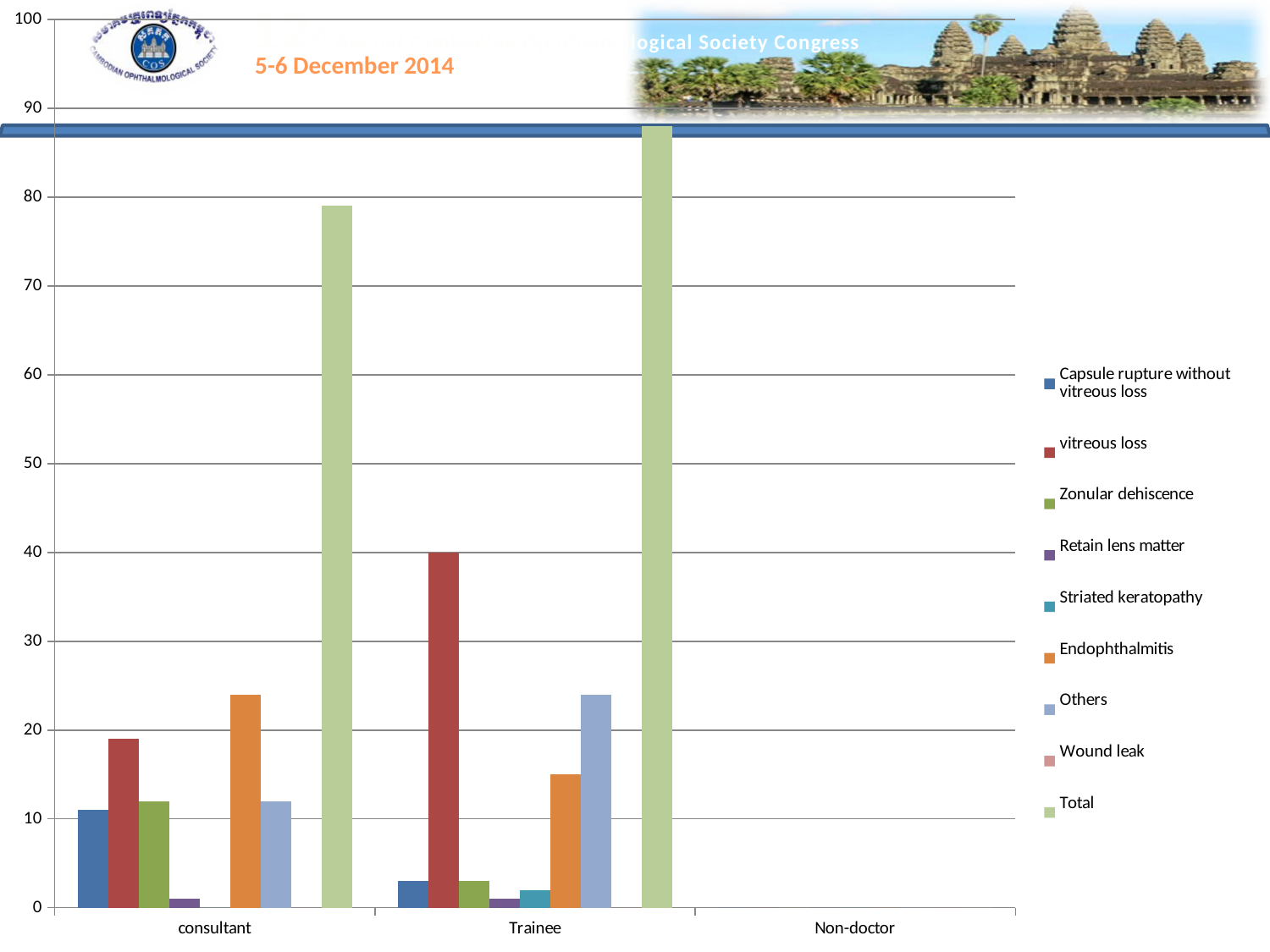
Which is larger: Others for consultant or Others for Trainee? Trainee Is the Total value for Trainee greater or less than 80? greater Which series has the tallest bar in the Trainee category? Total How many categories are shown on the x axis? 3 Which category on the x axis has no visible bars? Non-doctor Is the Endophthalmitis value for consultant greater or less than 20? greater What kind of chart is shown on the slide? bar chart Which series has the tallest bar in the consultant category? Total Which is larger: vitreous loss for consultant or vitreous loss for Trainee? Trainee How many series does the legend list? 9 What is the value of vitreous loss for Trainee? 40